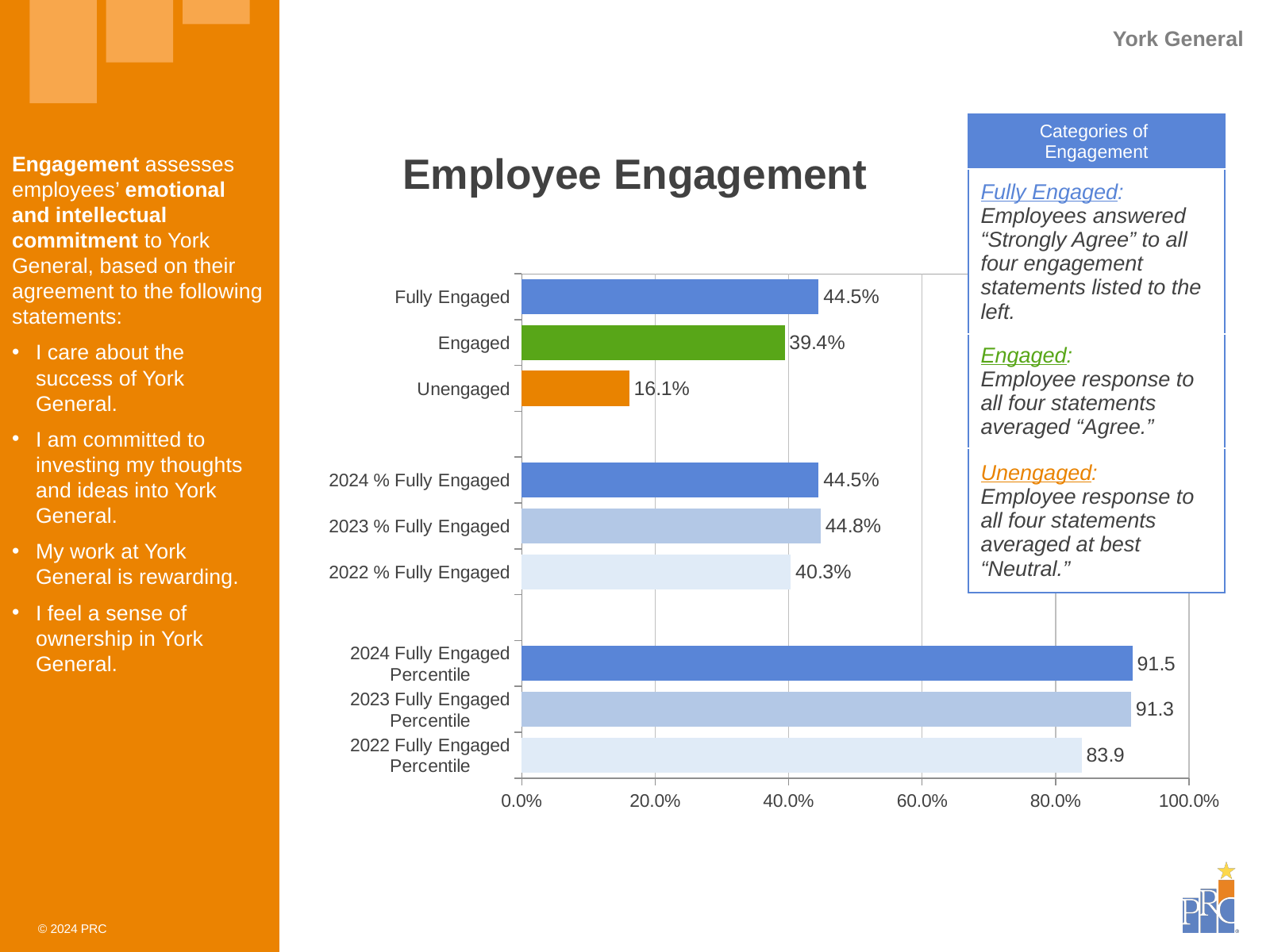
What is the value for Engaged in the Employee Engagement chart? 39.4% Which bar in the Employee Engagement chart has the highest value? 2024 Fully Engaged Percentile What is the 2023 % Fully Engaged value shown in the chart? 44.8% Which is larger, the 2022 % Fully Engaged or the 2024 % Fully Engaged? 2024 % Fully Engaged How many bars are plotted in the Employee Engagement chart? 9 Which bar in the Employee Engagement chart has the lowest value? Unengaged Is the value for Unengaged greater or less than 20.0%? less What is the 2022 Fully Engaged Percentile shown in the chart? 83.9 What is the difference between the Fully Engaged and Engaged percentages? 5.1% What is the difference between the 2024 Fully Engaged Percentile and the 2022 Fully Engaged Percentile? 7.6 What is the value for Unengaged in the Employee Engagement chart? 16.1% What type of chart is used on this slide? bar chart